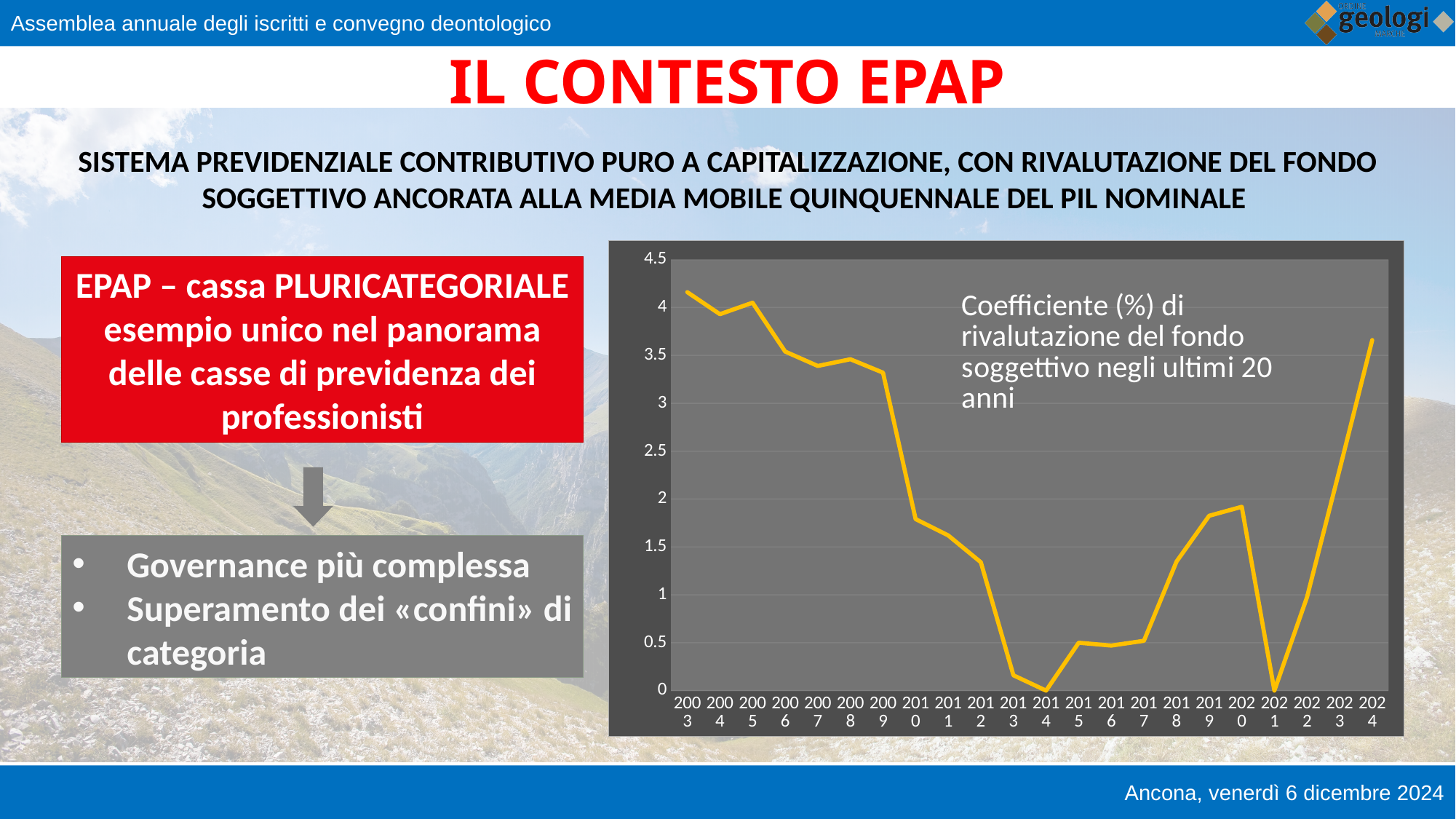
Is the value for 2003 greater or less than 4? greater How many years (data points) are plotted on the x axis of the chart? 22 Do the values rise or fall from 2021 to 2024? rise Is the value for 2013 greater or less than 0.5? less Is the value for 2024 greater or less than 3.5? greater What kind of chart is shown on the slide? line chart What is the last year shown on the x axis of the chart? 2024 Which year has the larger value, 2009 or 2010? 2009 Which year has the larger value, 2021 or 2022? 2022 What is the first year shown on the x axis of the chart? 2003